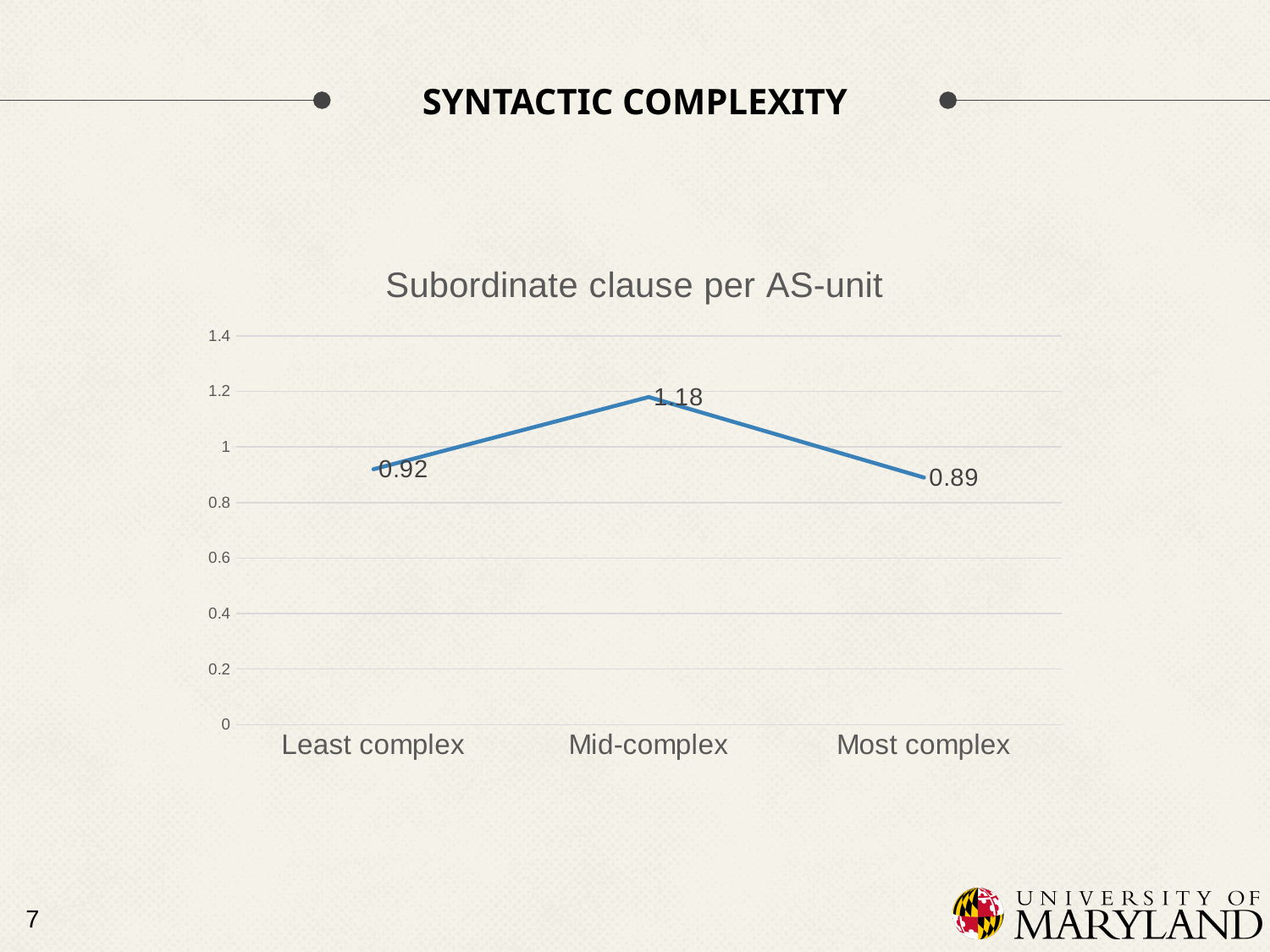
What kind of chart is shown on the slide? line chart What is the title of the chart? Subordinate clause per AS-unit What is the difference between the values for Mid-complex and Least complex? 0.26 What is the difference between the values for Least complex and Most complex? 0.03 Which category has the highest value? Mid-complex How many categories are shown on the x axis? 3 What is the value for Most complex? 0.89 Which is larger, the value for Mid-complex or the value for Most complex? Mid-complex What is the value for Least complex? 0.92 Is the value for Mid-complex greater or less than 1? greater Which category has the lowest value? Most complex What is the value for Mid-complex? 1.18